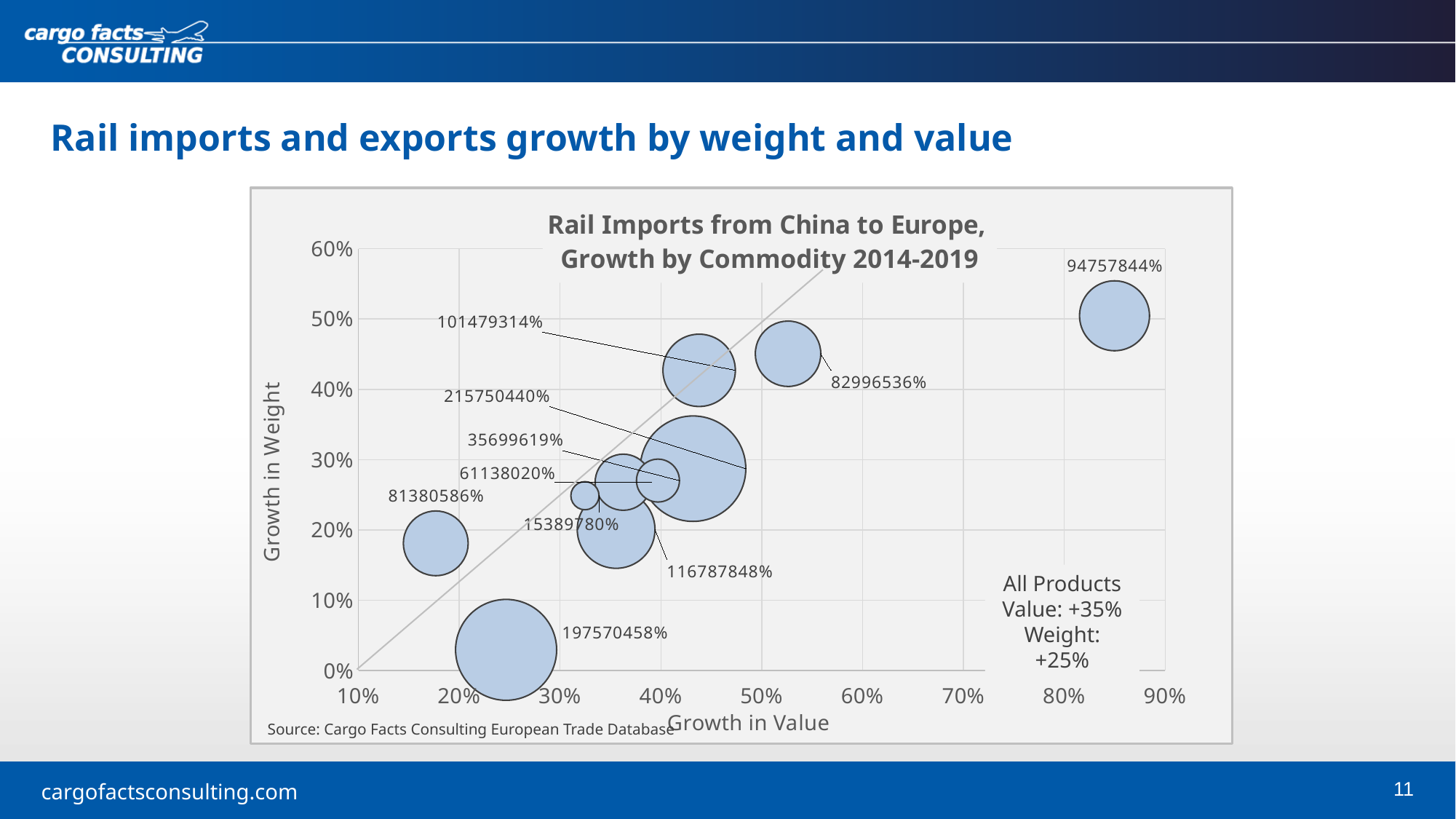
How many bubbles are plotted on the chart? 10 Which bubble has the highest growth in value? 94757844% What is the label of the vertical axis of the chart? Growth in Weight Is the growth in value for the bubble labelled 94757844% greater or less than 80%? greater Is the growth in weight for the bubble labelled 94757844% greater or less than 40%? greater What kind of chart is shown on the slide? bubble chart Which bubble has the lowest growth in weight? 197570458% Is the growth in value for the bubble labelled 81380586% greater or less than 30%? less Which bubble has a higher growth in weight, 94757844% or 197570458%? 94757844% According to the annotation on the chart, what is the growth in value for All Products? +35% What is the title of the chart? Rail Imports from China to Europe, Growth by Commodity 2014-2019